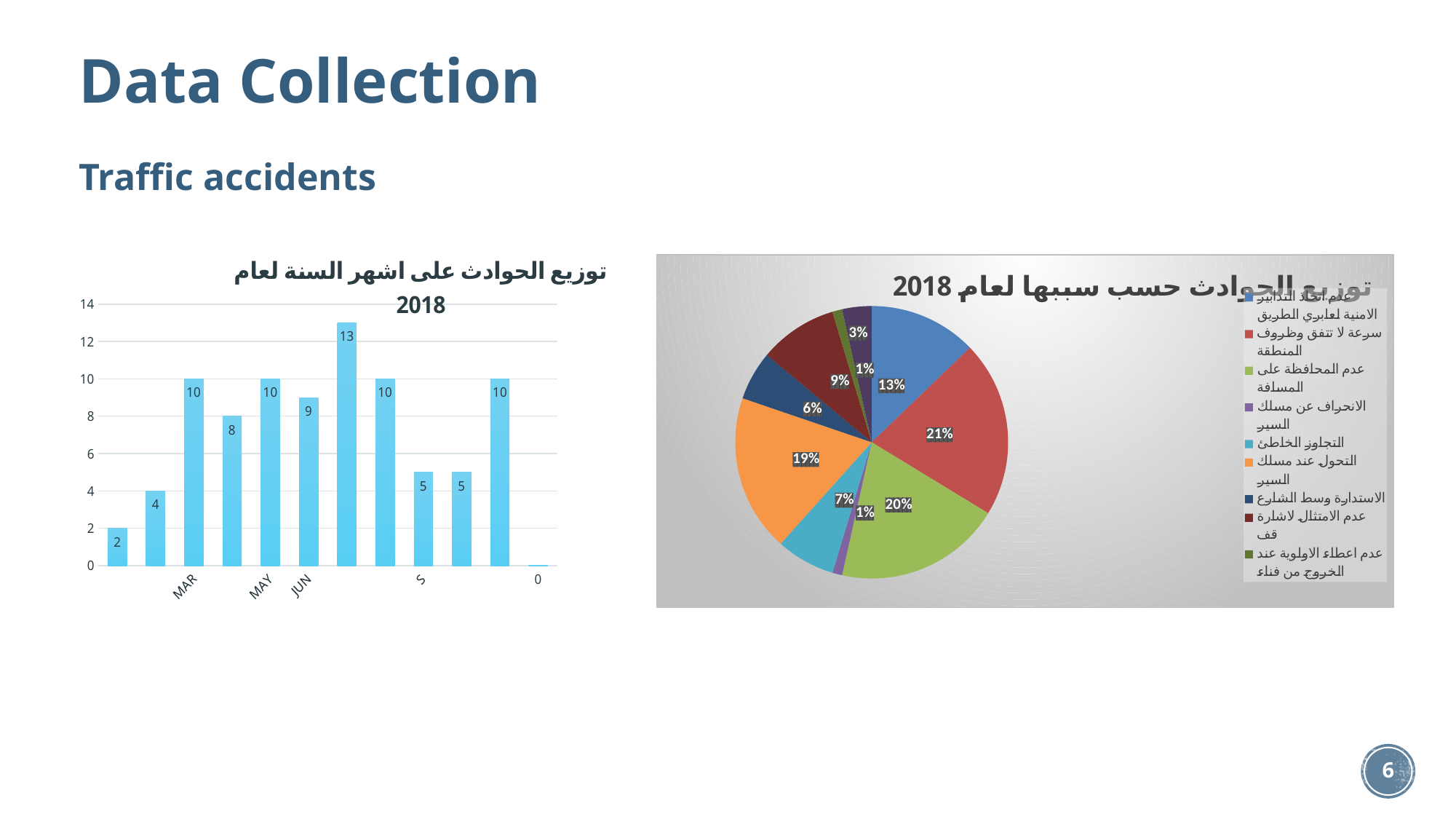
How many bars are plotted in the left bar chart? 12 In the left bar chart, what is the highest value shown on any bar? 13 In the left bar chart, what is the difference between the highest bar (13) and the value for MAR? 3 In the left bar chart, what is the value for JUN? 9 What kind of chart is the left chart titled 'توزيع الحوادث على اشهر السنة لعام 2018'? bar chart In the left bar chart, what is the value for MAR? 10 In the right pie chart, what share is shown for 'عدم الامتثال لاشارة قف'? 9% What kind of chart is the right chart titled 'توزيع الحوادث حسب سببها لعام 2018'? pie chart In the left bar chart, which is larger, the value for MAY or the value for JUN? MAY In the right pie chart, what percentage does the largest slice represent? 21% In the right pie chart, what share is shown for 'التجاوز الخاطئ'? 7% In the left bar chart, what is the difference between the value for MAY and the value for JUN? 1